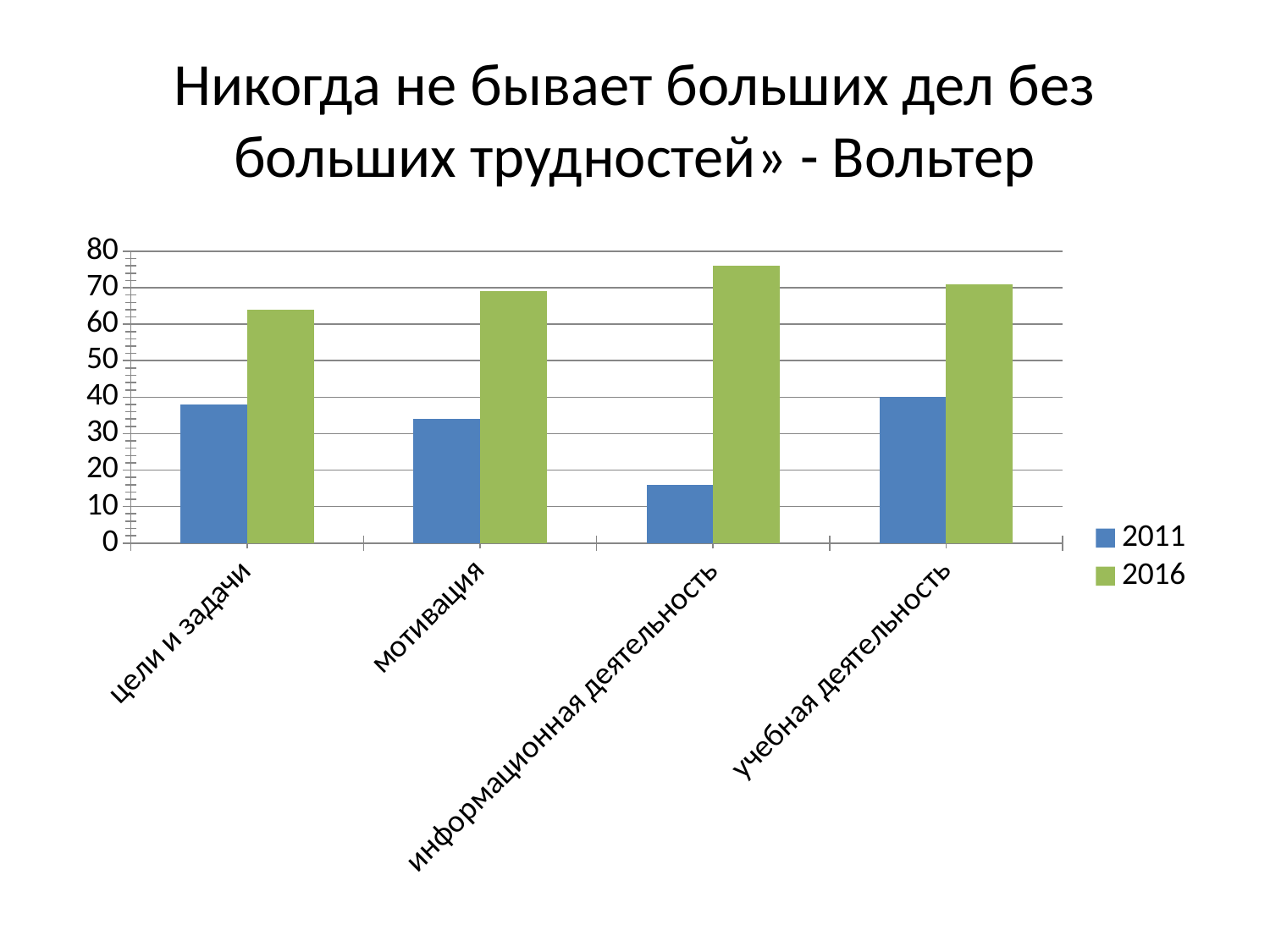
For учебная деятельность, which series has the larger value, 2011 or 2016? 2016 Is the 2011 value for мотивация greater or less than 30? greater Which series is shown in green in the legend? 2016 Which category has the lowest value for the 2011 series? информационная деятельность How many categories are shown on the x axis? 4 Which category has the lowest value for the 2016 series? цели и задачи Which category has the highest value for the 2016 series? информационная деятельность Is the 2011 value for информационная деятельность greater or less than 20? less How many series does the legend list? 2 Is the 2016 value for цели и задачи greater or less than 70? less What kind of chart is shown on the slide? bar chart